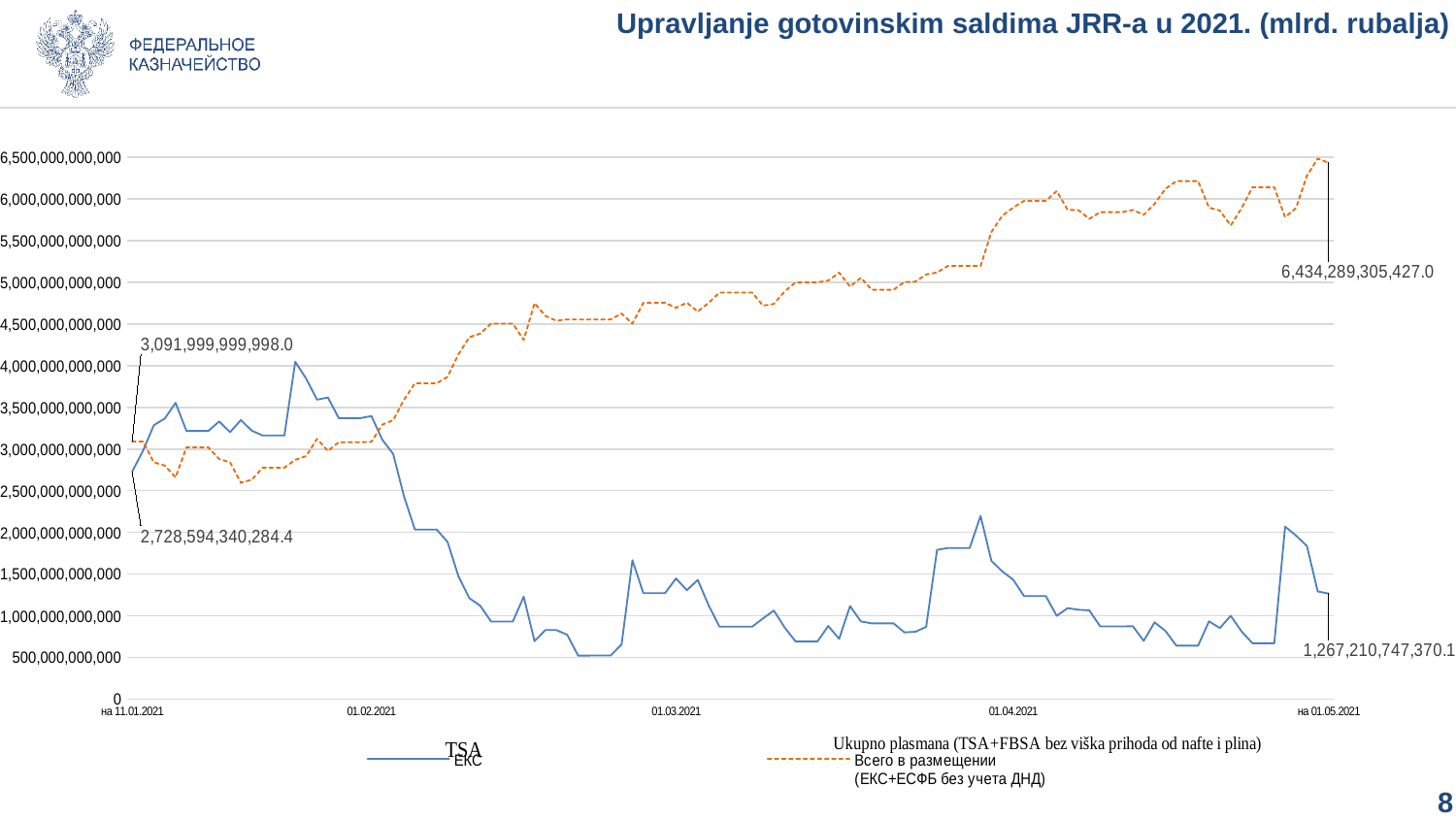
What is the value of Ukupno plasmana (TSA+FBSA bez viška prihoda od nafte i plina) at the start of the period (на 11.01.2021)? 3,091,999,999,998.0 What is the difference between the Ukupno plasmana value and the TSA value at the start of the period (на 11.01.2021)? 363,405,659,713.6 What is the value of Ukupno plasmana (TSA+FBSA bez viška prihoda od nafte i plina) at the end of the period (на 01.05.2021)? 6,434,289,305,427.0 What kind of chart is shown on the slide? line chart How many series does the legend list? 2 What is the difference between the Ukupno plasmana value and the TSA value at the end of the period (на 01.05.2021)? 5,167,078,558,056.9 What is the TSA value at the start of the period (на 11.01.2021)? 2,728,594,340,284.4 Does the TSA line rise or fall overall from 11.01.2021 to 01.05.2021? fall What is the TSA value at the end of the period (на 01.05.2021)? 1,267,210,747,370.1 At 01.05.2021, which series has the larger value, TSA or Ukupno plasmana? Ukupno plasmana Is the value of Ukupno plasmana at 01.03.2021 greater or less than 4,000,000,000,000? greater Does the Ukupno plasmana line rise or fall overall from 11.01.2021 to 01.05.2021? rise